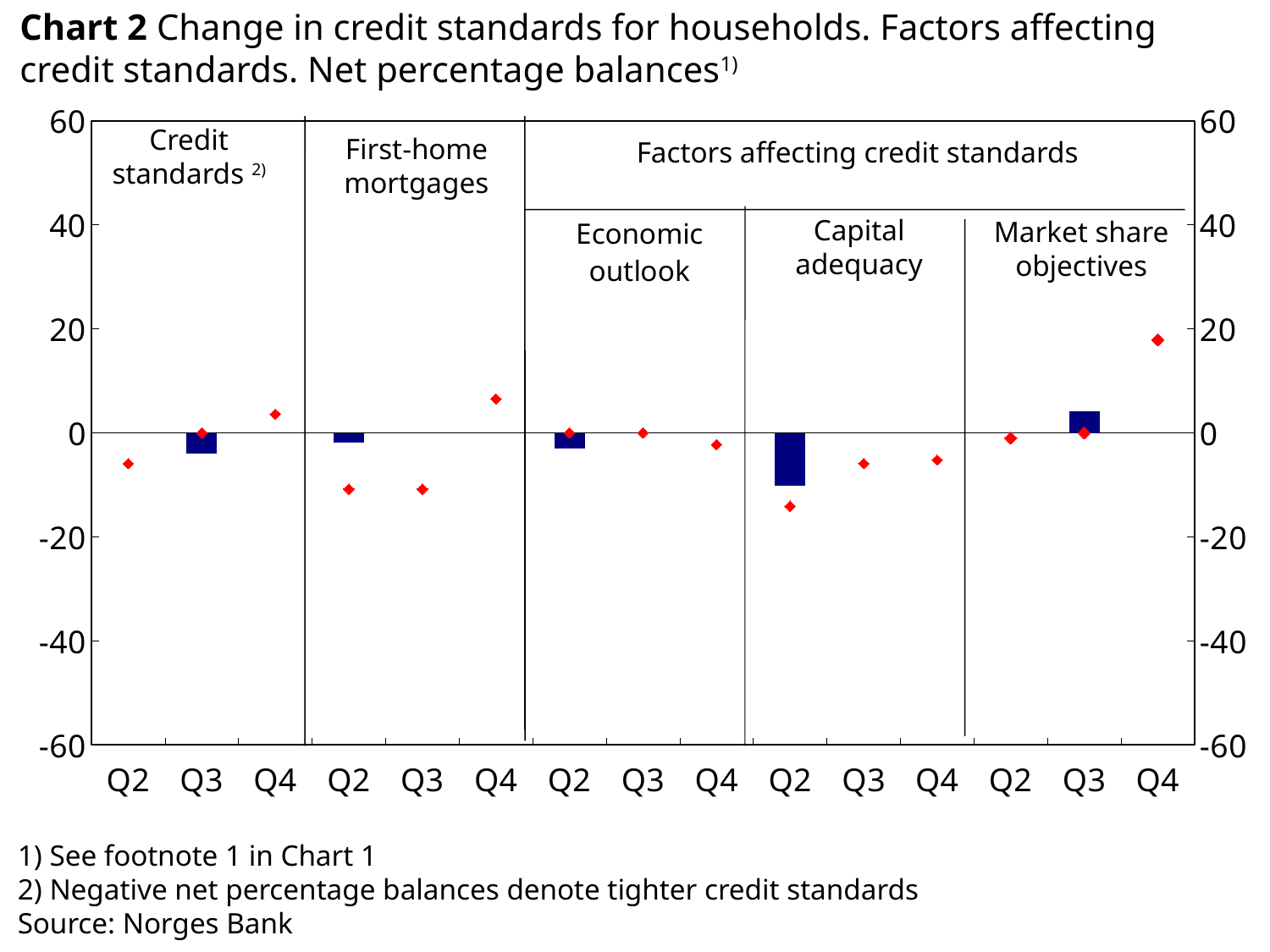
What kind of chart is Chart 2? combination bar and line chart (blue bars with red diamond markers) What are the three factors affecting credit standards listed in Chart 2? Economic outlook, Capital adequacy, Market share objectives Which panel and quarter has the lowest red marker in the whole chart? Capital adequacy, Q2 In the Market share objectives panel, is the red marker for Q4 greater or less than 10? greater In the Credit standards panel, which red marker is higher, Q2 or Q4? Q4 In the Capital adequacy panel, is the red marker for Q2 greater or less than -10? less In the Market share objectives panel, which quarter has the highest red marker? Q4 In the Capital adequacy panel, is the blue bar for Q2 greater or less than -5? less In the Market share objectives panel, do the red markers rise or fall from Q2 to Q4? rise How many panels (sections) does Chart 2 divide the x axis into? 5 How many quarter labels are shown along the x axis of Chart 2? 15